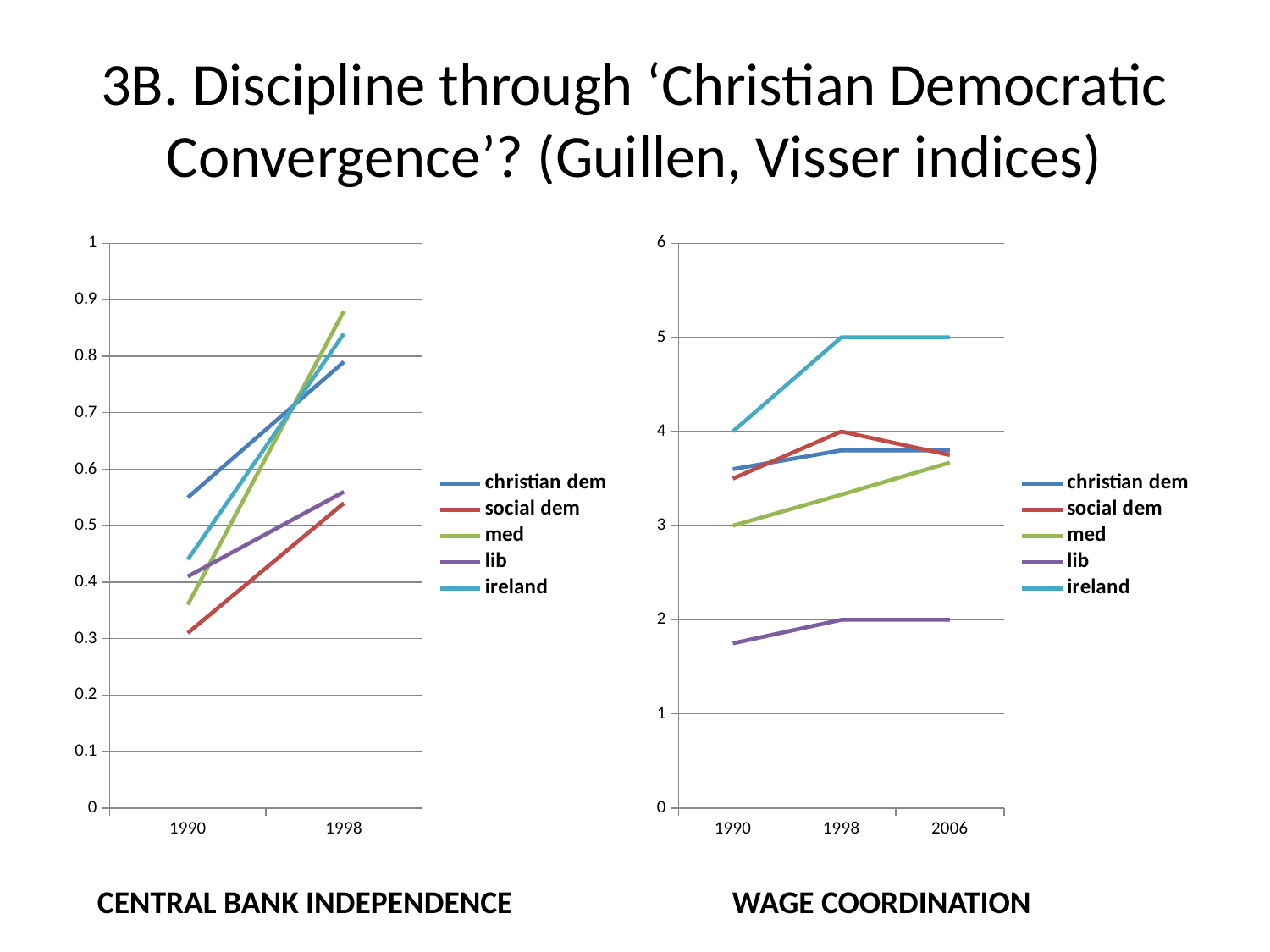
In the Central Bank Independence chart, does the value for christian dem rise or fall from 1990 to 1998? rise In the Wage Coordination chart, what is the value for med in 1990? 3 In the Wage Coordination chart, what is the value for ireland in 1998? 5 In the Wage Coordination chart, what is the value for social dem in 1998? 4 In the Wage Coordination chart, what is the value for lib in 2006? 2 In the Central Bank Independence chart, which series has the highest value in 1998? med In the Wage Coordination chart, which series has the highest value in 1998? ireland In the Wage Coordination chart, which series has the lowest value in 2006? lib What kind of chart is the Wage Coordination chart? line chart In the Central Bank Independence chart, is the value for social dem in 1990 greater or less than 0.4? less In the Wage Coordination chart, what is the difference between ireland and lib in 2006? 3 How many series does the legend of the Central Bank Independence chart list? 5